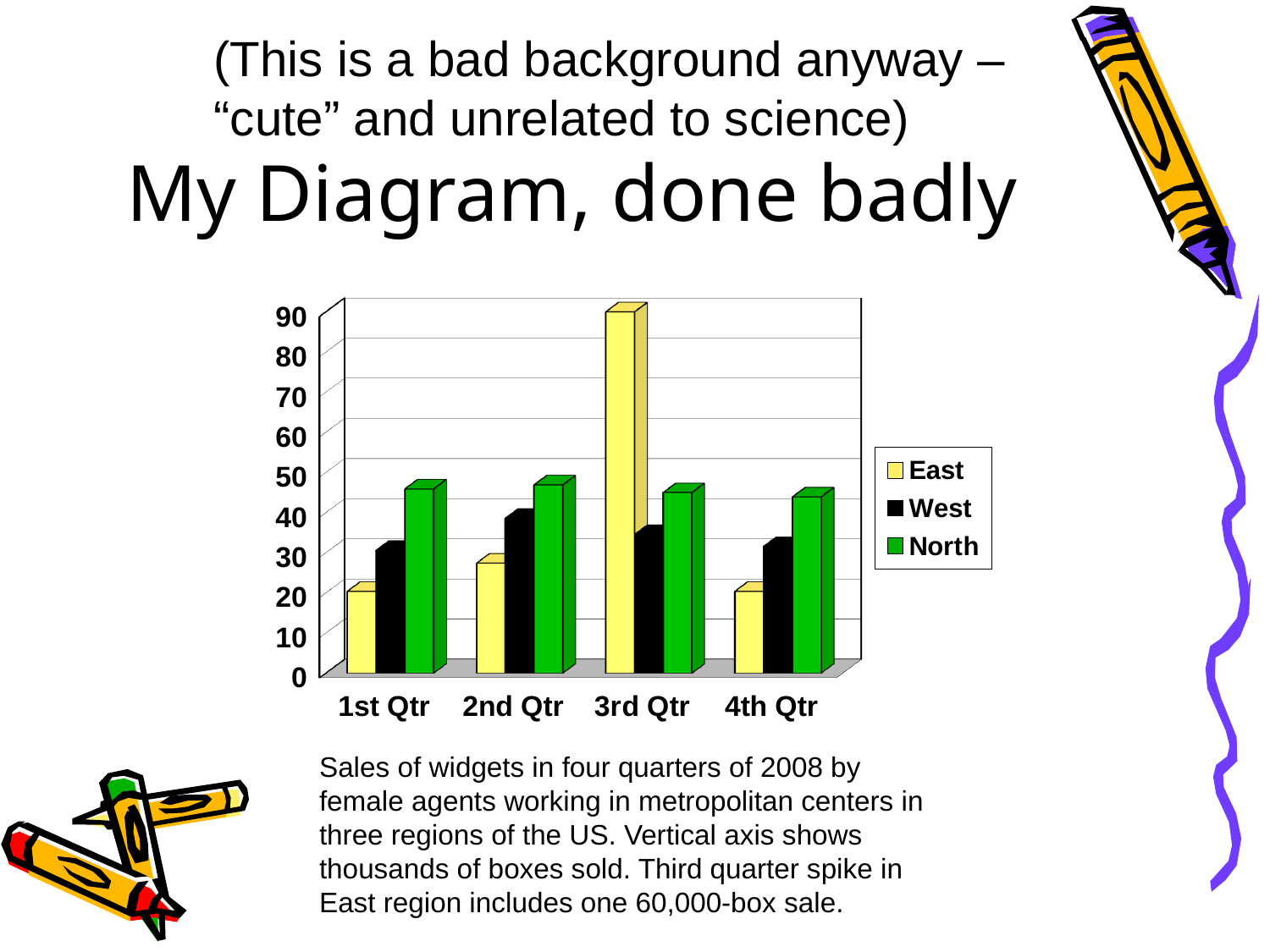
What kind of chart is shown on the slide? bar chart Is the East value for 1st Qtr greater or less than 30? less Is the West value for 2nd Qtr greater or less than 30? greater Which series has the lowest value in 1st Qtr? East Is the North value for 1st Qtr greater or less than 40? greater Which series are listed in the chart's legend? East, West, North How many series does the chart's legend list? 3 How many quarters (categories) are shown on the x axis of the chart? 4 What colour are the East bars in the chart? yellow In which quarter is the East value highest? 3rd Qtr In 3rd Qtr, which is larger, the East value or the West value? East